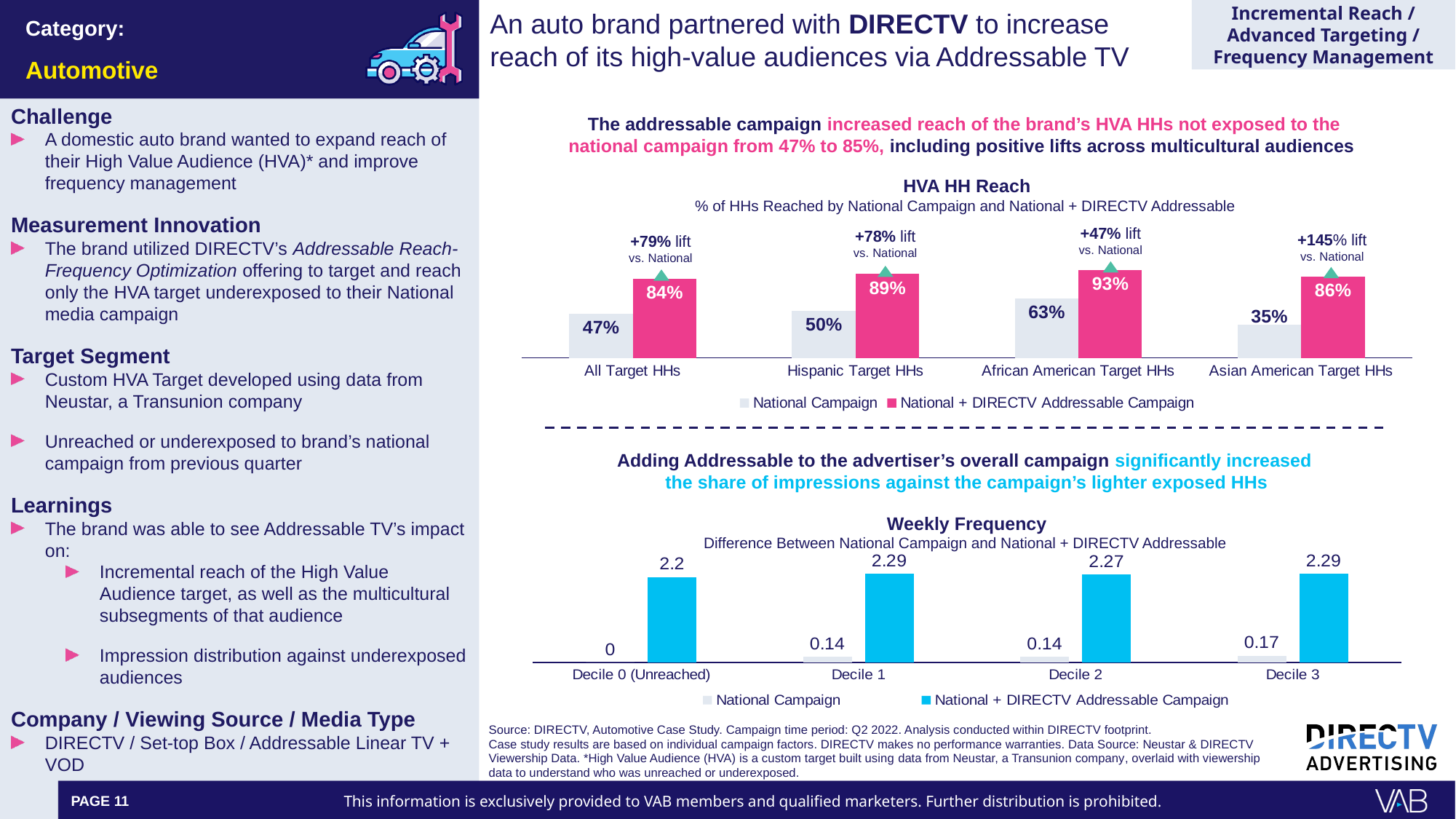
What type of chart is the Weekly Frequency chart? Bar chart In the HVA HH Reach chart, what lift vs. National is shown for Asian American Target HHs? +145% In the Weekly Frequency chart, what is the National + DIRECTV Addressable Campaign value for Decile 0 (Unreached)? 2.2 In the Weekly Frequency chart, which is larger: the National + DIRECTV Addressable Campaign value for Decile 1 or for Decile 2? Decile 1 How many series does the legend of the Weekly Frequency chart list? 2 In the HVA HH Reach chart, what is the National + DIRECTV Addressable Campaign value for African American Target HHs? 93% In the HVA HH Reach chart, what is the National Campaign value for All Target HHs? 47% In the Weekly Frequency chart, what is the National Campaign value for Decile 3? 0.17 In the HVA HH Reach chart, which category has the highest National + DIRECTV Addressable Campaign value? African American Target HHs In the HVA HH Reach chart, which category has the lowest National Campaign value? Asian American Target HHs In the HVA HH Reach chart, what is the difference between the National + DIRECTV Addressable Campaign value and the National Campaign value for Hispanic Target HHs? 39% In the HVA HH Reach chart, how many categories are shown on the x axis? 4